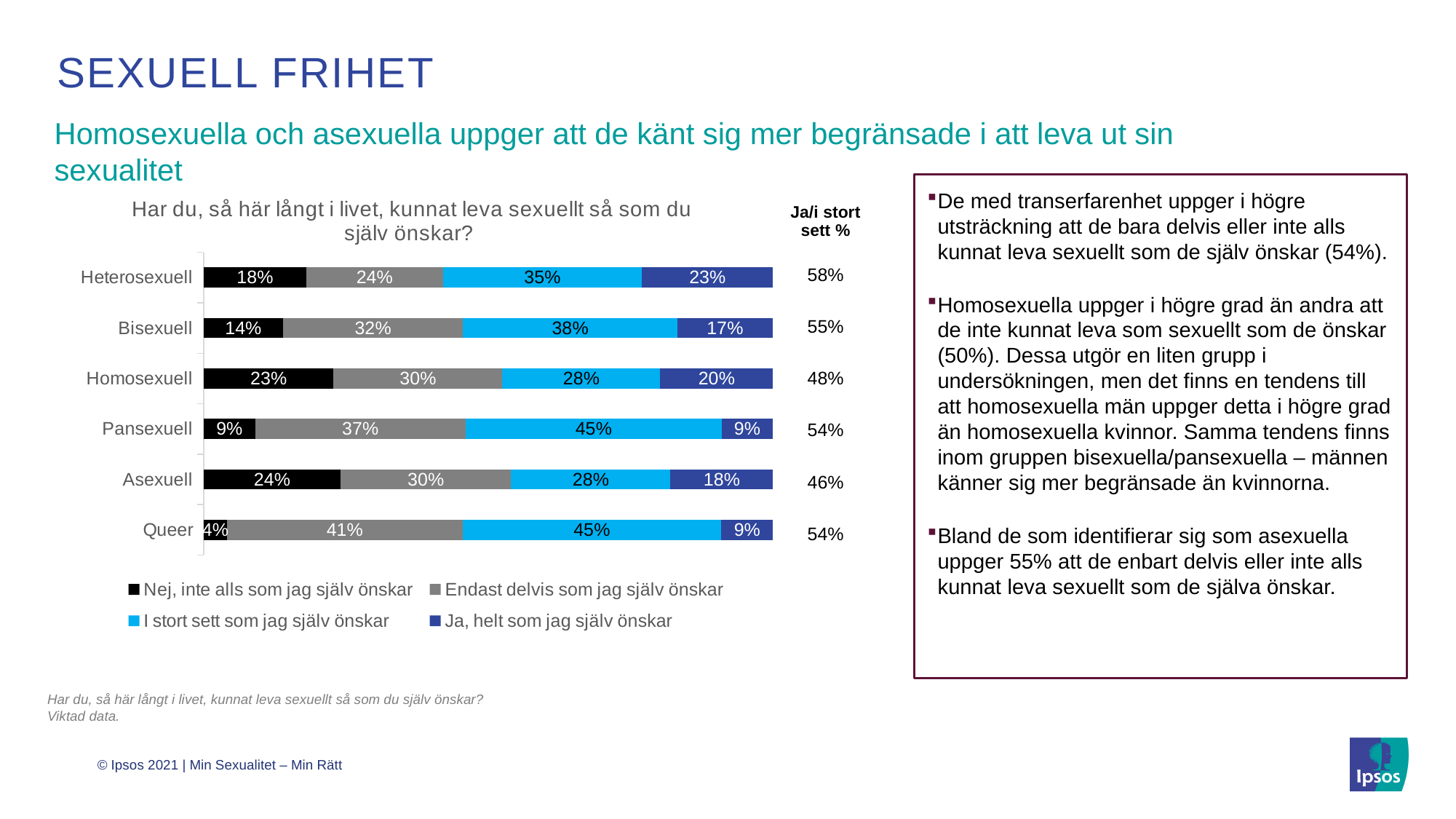
What kind of chart is shown on the slide? Stacked bar chart What is the "Ja/i stort sett %" value shown for Homosexuell? 48% How many categories (sexual orientations) are shown in the chart? 6 What share of Queer respondents answered "Endast delvis som jag själv önskar"? 41% Which category has the lowest value for "Nej, inte alls som jag själv önskar"? Queer What percentage of Heterosexuell respondents answered "Nej, inte alls som jag själv önskar"? 18% What is the total of the four segments in the Heterosexuell bar? 100% How many percentage points higher is the "Endast delvis som jag själv önskar" value for Bisexuell than for Heterosexuell? 8 percentage points How many series does the legend list? 4 Which category has the highest value for "Ja, helt som jag själv önskar"? Heterosexuell What is the value for Pansexuell in the "I stort sett som jag själv önskar" series? 45% Which has a larger "I stort sett som jag själv önskar" value, Homosexuell or Bisexuell? Bisexuell